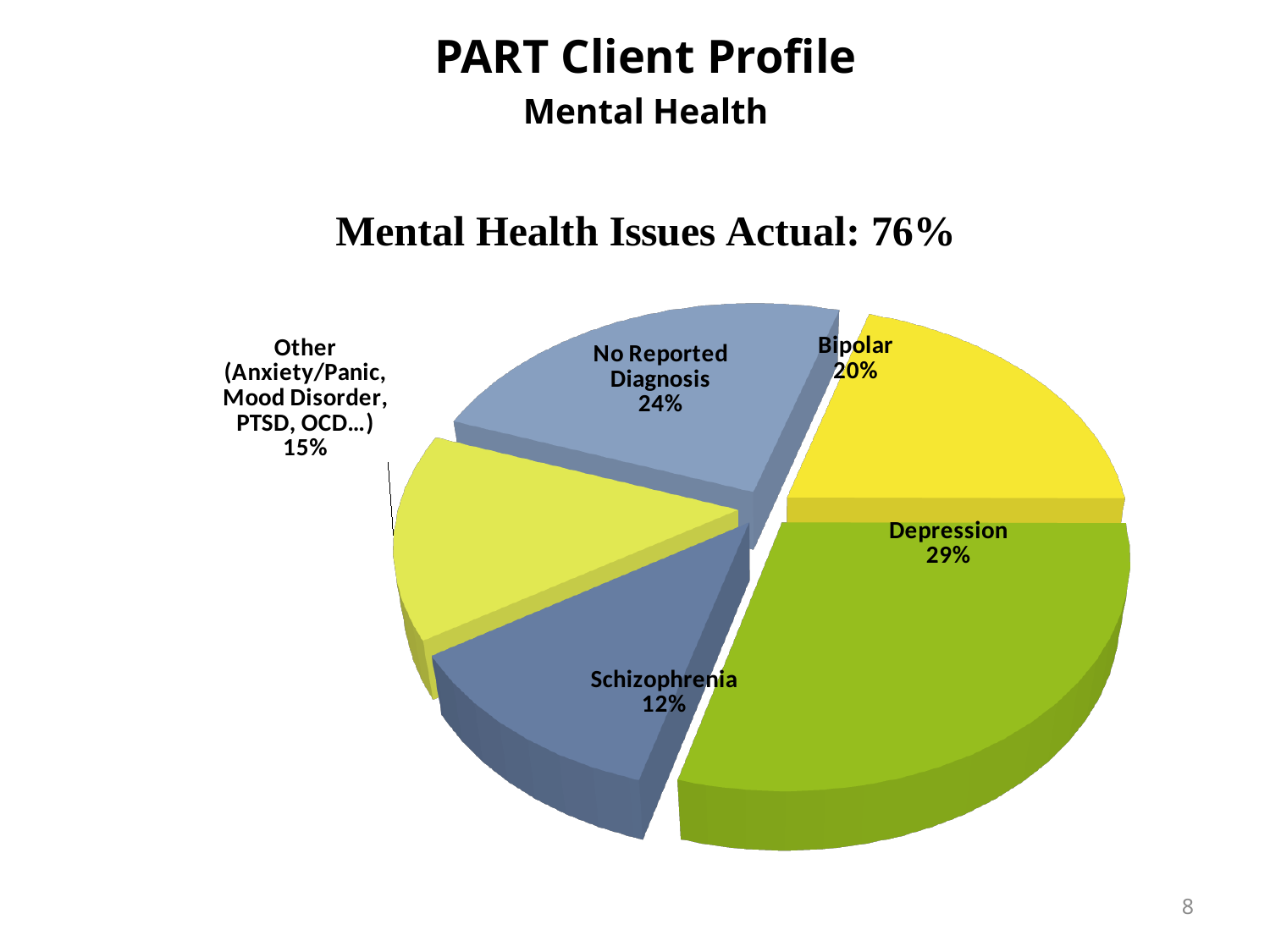
What percentage of the pie is Bipolar? 20% What percentage of the pie is Depression? 29% Which is larger, the Bipolar slice or the Other slice? Bipolar What is the difference in percentage points between Depression and Bipolar? 9 How many slices does the pie chart have? 5 Which slice of the pie is the smallest? Schizophrenia What percentage of the pie is No Reported Diagnosis? 24% What kind of chart is shown on the slide? Pie chart What percentage of the pie is Schizophrenia? 12% What is the title shown above the pie chart? Mental Health Issues Actual: 76% Which slice of the pie is the largest? Depression What percentage of the pie is Other (Anxiety/Panic, Mood Disorder, PTSD, OCD...)? 15%